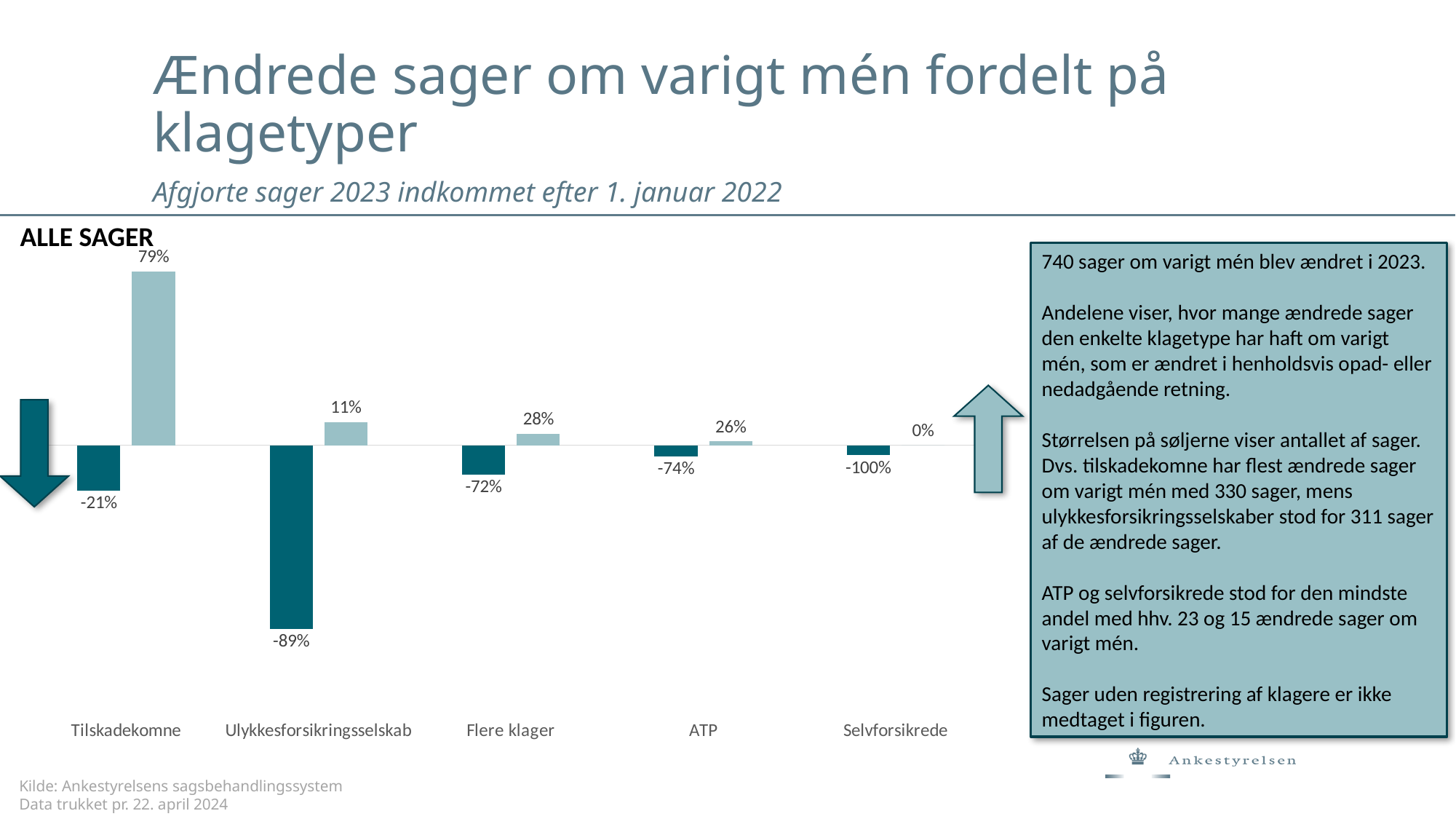
What is the upward (light) value for Tilskadekomne? 79% What is the downward (dark) value for Ulykkesforsikringsselskab? -89% What is the difference between the upward values for Tilskadekomne (79%) and Ulykkesforsikringsselskab (11%)? 68 percentage points Which is larger, the upward value for Flere klager or the upward value for ATP? Flere klager What kind of chart is shown on the slide? Bar chart What is the downward (dark) value for Selvforsikrede? -100% Which category has the highest upward (light) value? Tilskadekomne Which category has the lowest upward (light) value? Selvforsikrede What is the downward (dark) value for Flere klager? -72% What is the title printed above the chart? ALLE SAGER What is the upward (light) value for ATP? 26% How many categories are shown on the x axis? 5